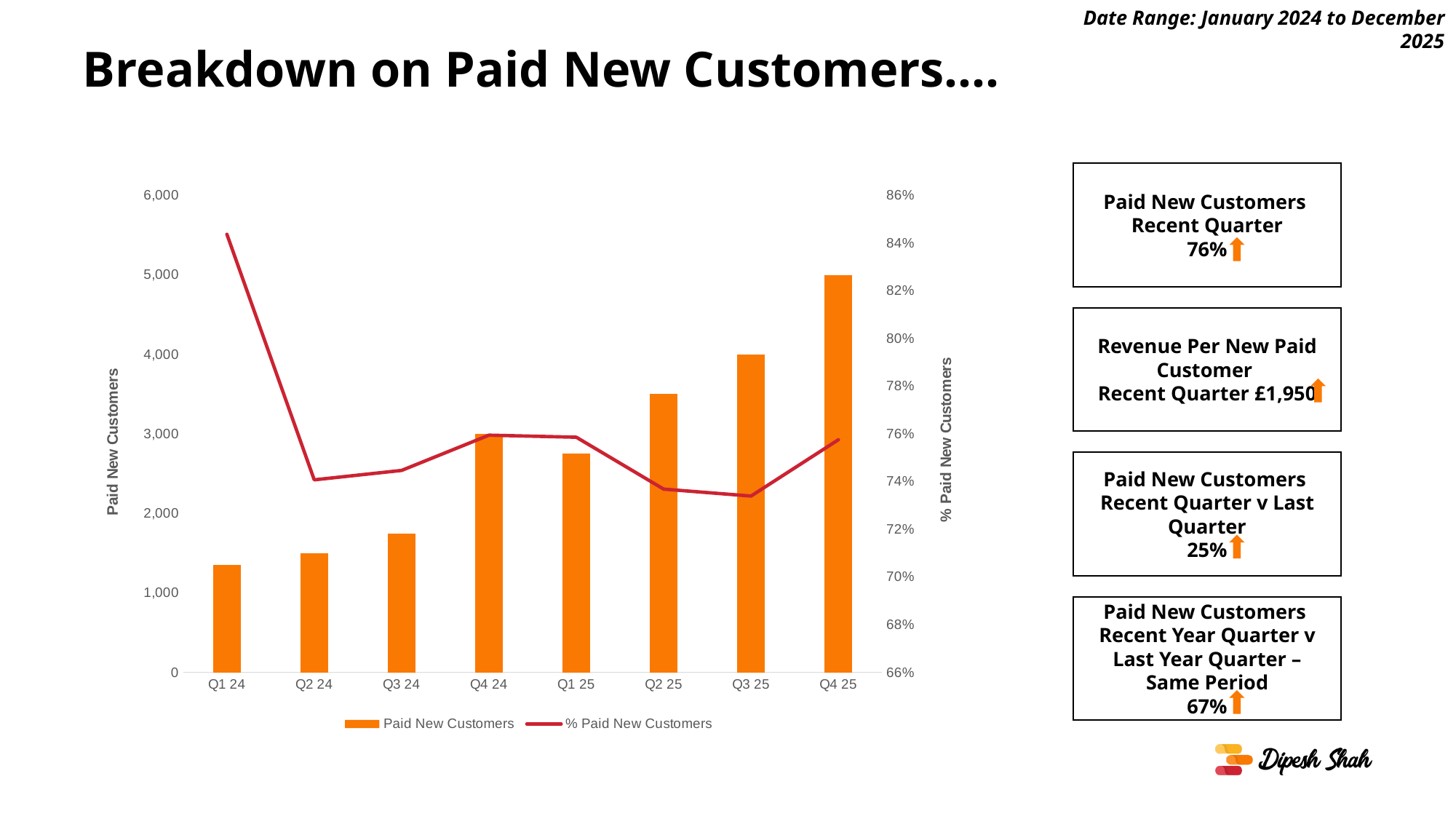
Is the % Paid New Customers for Q1 24 greater or less than 80%? greater Which quarter has the highest number of Paid New Customers? Q4 25 How many series does the chart legend list? 2 Which is larger, Paid New Customers in Q4 24 or in Q1 25? Q4 24 Which quarter has the lowest number of Paid New Customers? Q1 24 How many quarters are shown on the x axis of the chart? 8 What is the value of Paid New Customers for Q3 25? 4,000 Is the value of Paid New Customers for Q2 25 greater or less than 3,000? greater What kind of chart is shown on the slide? Combined bar and line chart What is the value of Paid New Customers for Q4 25? 5,000 Which quarter has the highest % Paid New Customers? Q1 24 Is the value of Paid New Customers for Q3 24 greater or less than 2,000? less